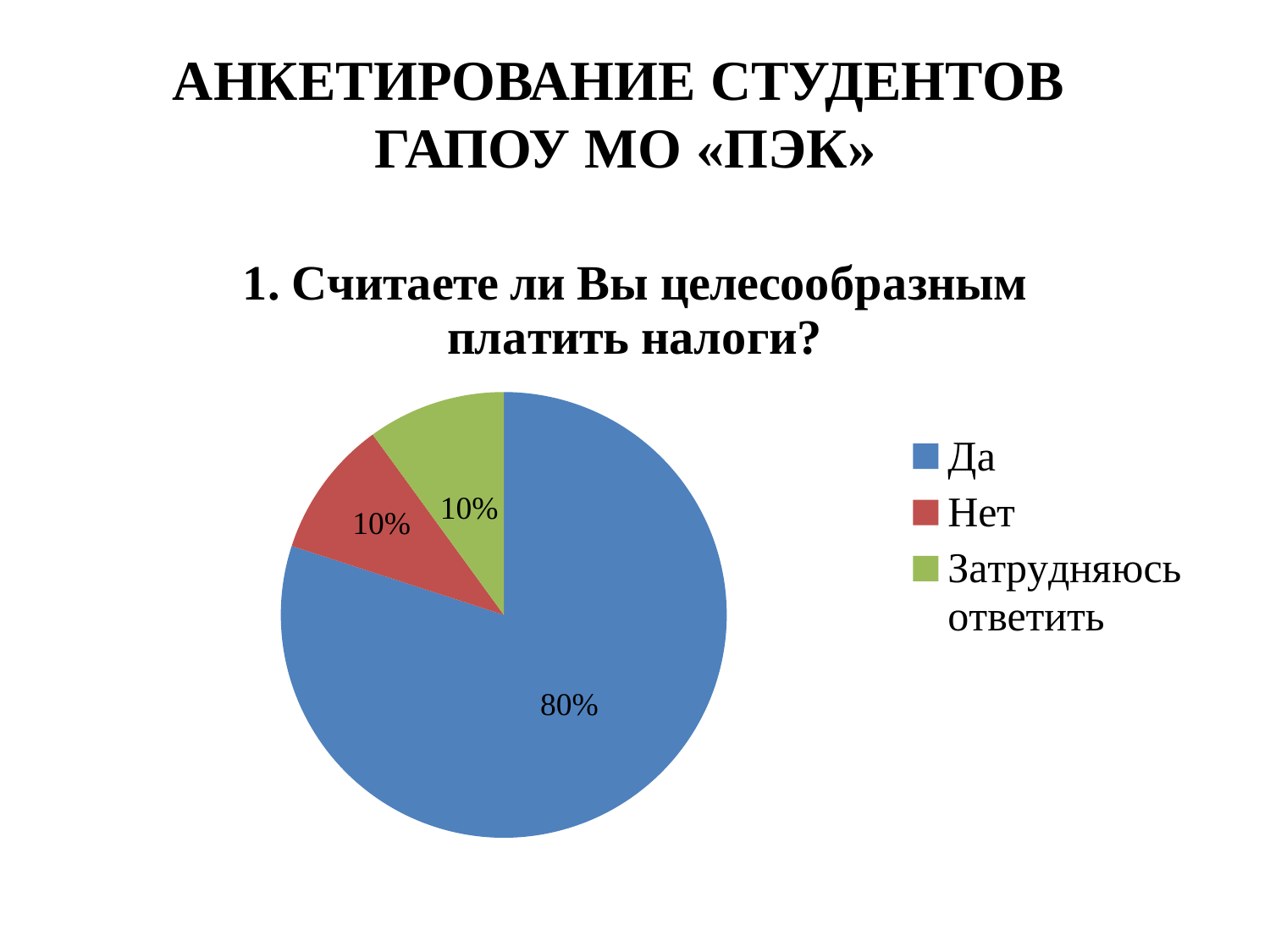
What share of the pie does "Затрудняюсь ответить" take? 10% Which is larger, the share for "Да" or the share for "Затрудняюсь ответить"? Да What share of the pie does "Да" take? 80% What is the title of the chart? 1. Считаете ли Вы целесообразным платить налоги? What colour is the slice for "Нет"? red Which category has the largest slice of the pie? Да What is the difference between the share for "Да" and the share for "Нет"? 70% How many slices does the pie chart have? 3 What share of the pie does "Нет" take? 10% How many entries does the legend list? 3 What kind of chart is shown on the slide? pie chart